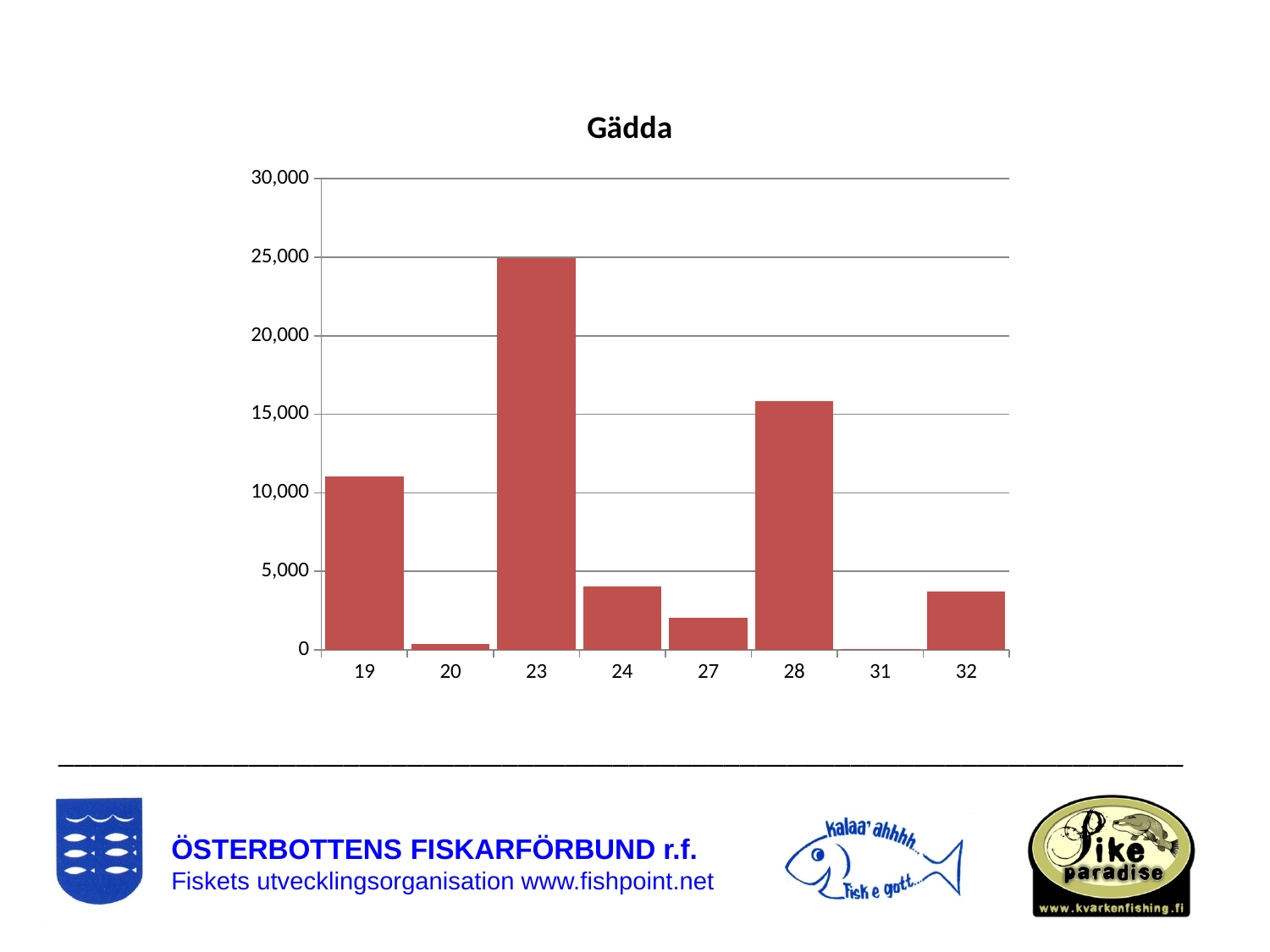
What is the title of the chart? Gädda How many categories are shown on the x axis of the chart? 8 Which category has the lowest value in the chart? 31 What kind of chart is shown on the slide? bar chart Which category has the highest value in the chart? 23 What is the highest value shown on the y axis of the chart? 30,000 Is the value for category 19 greater or less than 10,000? greater Is the value for category 32 greater or less than 5,000? less Which has the larger value, category 19 or category 28? 28 Which has the larger value, category 24 or category 27? 24 Is the value for category 23 greater or less than 20,000? greater